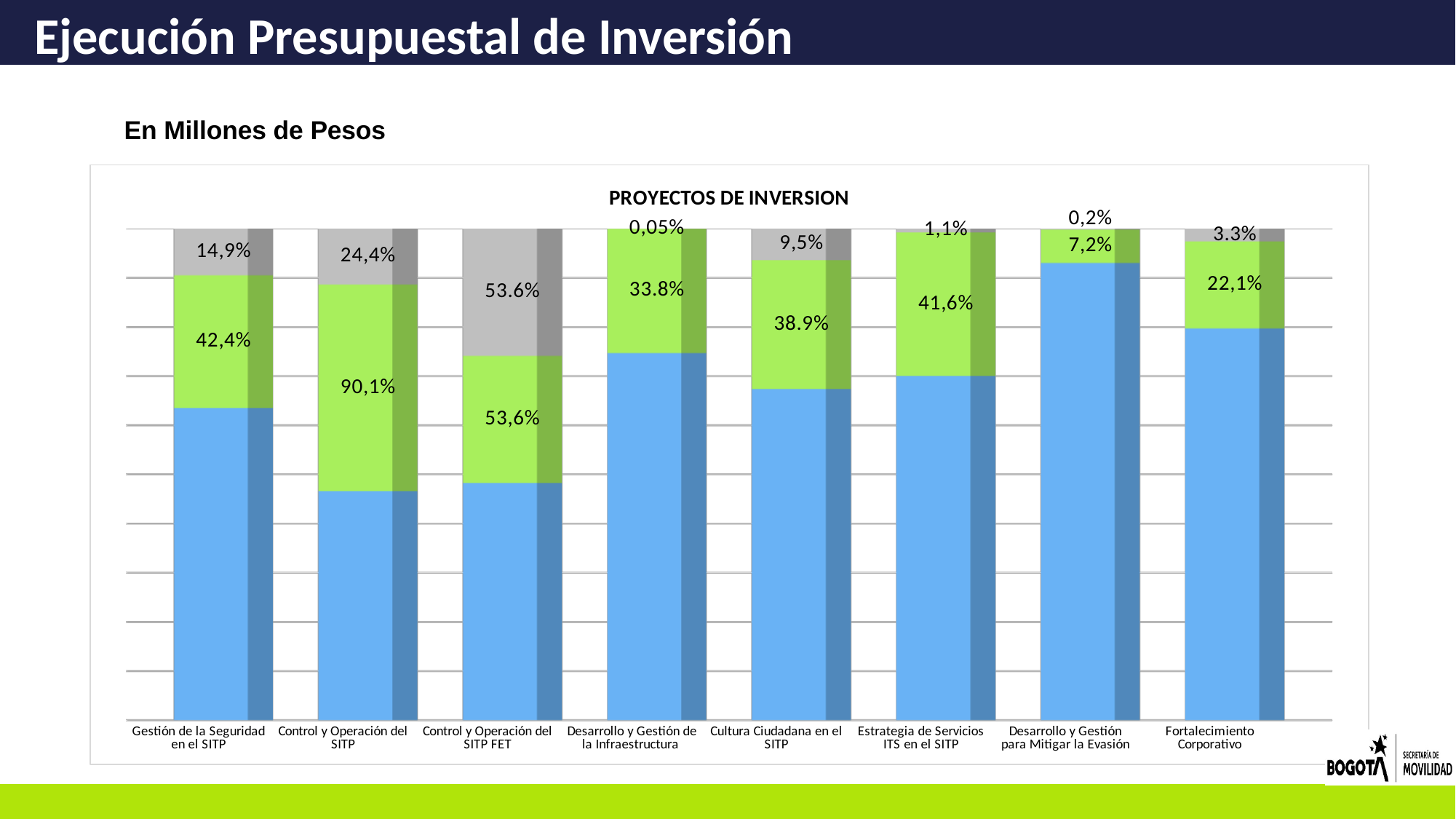
What is the grey segment label for Gestión de la Seguridad en el SITP? 14,9% What is the green segment label for Control y Operación del SITP? 90,1% What kind of chart is shown on the slide? Stacked bar chart How many project categories are shown along the x axis? 8 What is the green segment label for Fortalecimiento Corporativo? 22,1% What is the title of the chart? PROYECTOS DE INVERSION What is the grey segment label for Desarrollo y Gestión de la Infraestructura? 0,05% Which has the larger green segment label, Gestión de la Seguridad en el SITP or Cultura Ciudadana en el SITP? Gestión de la Seguridad en el SITP Which category has the lowest green segment label? Desarrollo y Gestión para Mitigar la Evasión What is the green segment label for Estrategia de Servicios ITS en el SITP? 41,6% Which category has the highest grey segment label? Control y Operación del SITP FET Which category has the highest green segment label? Control y Operación del SITP